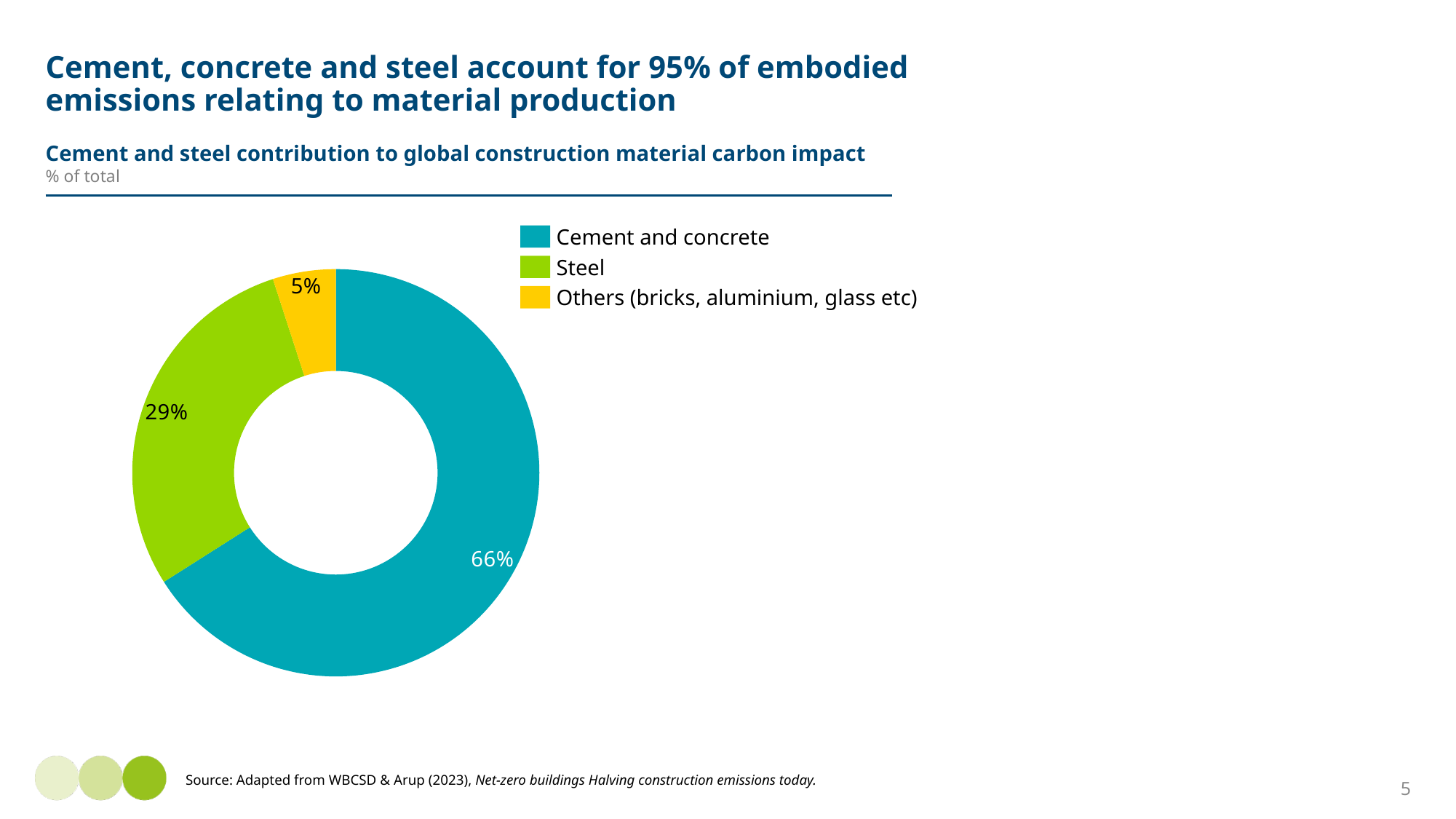
Which category has the smallest share of the chart? Others (bricks, aluminium, glass etc) What is the combined share of Cement and concrete and Steel? 95% What colour represents Steel in the chart? Green What share of global construction material carbon impact is attributed to Steel? 29% What is the difference in percentage points between the Cement and concrete share and the Steel share? 37 What is the title of the chart? Cement and steel contribution to global construction material carbon impact How many categories are shown in the chart? 3 What share of global construction material carbon impact is attributed to Cement and concrete? 66% Which has a larger share, Steel or Others (bricks, aluminium, glass etc)? Steel What kind of chart is shown on the slide? Pie chart (doughnut) Which category has the largest share of the chart? Cement and concrete What share of global construction material carbon impact is attributed to Others (bricks, aluminium, glass etc)? 5%